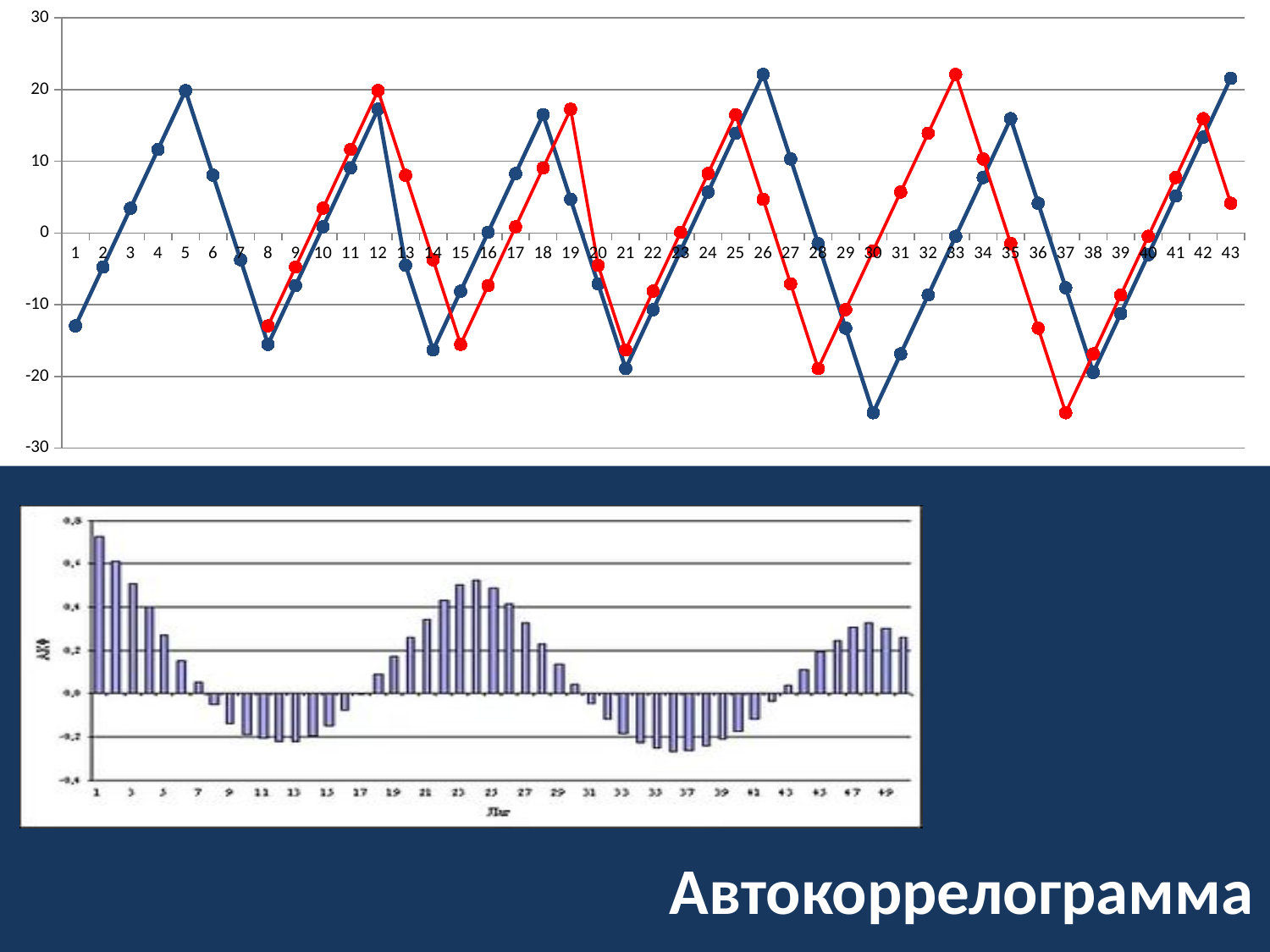
In the top chart, is the value of the blue line at x = 30 greater or less than -20? less In the top chart, is the value of the red line at x = 33 greater or less than 20? greater What kind of chart is the bottom chart on the slide? bar chart What is the title shown below the bottom chart? Автокоррелограмма In the top chart, how many points are labelled along the x axis? 43 In the top chart, how many lines are plotted? 2 In the top chart, does the blue line rise or fall from x = 1 to x = 5? rise In the top chart, is the value of the blue line at x = 1 greater or less than -10? less In the top chart, at x = 19, which line has the larger value, blue or red? red In the top chart, at which x value does the blue line reach its lowest point? 30 What kind of chart is the top chart on the slide? line chart In the top chart, at x = 26, which line has the larger value, blue or red? blue